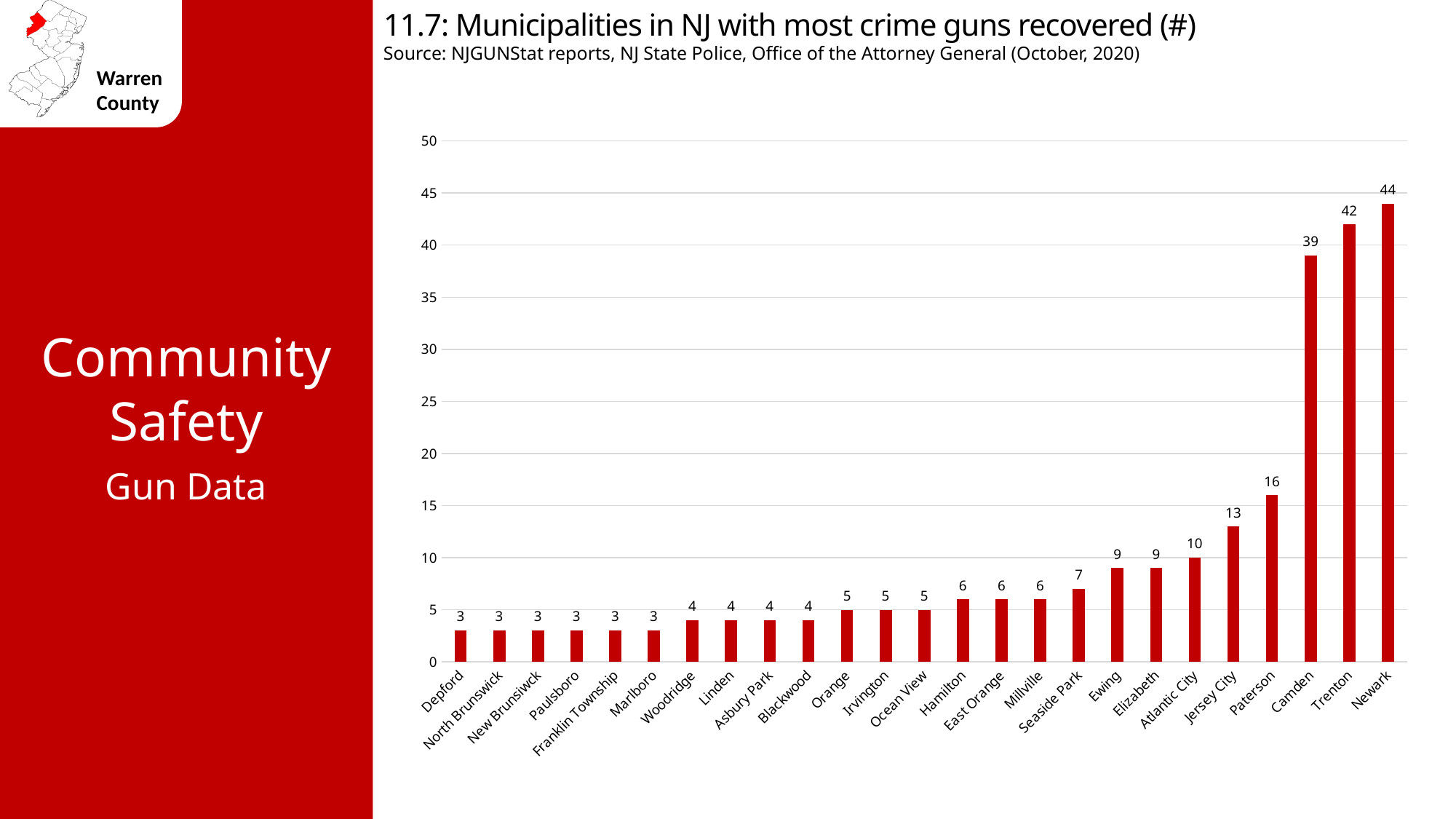
Which has a larger value, Jersey City or Elizabeth? Jersey City Is the value for Trenton greater or less than 40? greater What is the value shown for Camden? 39 What is the value for Atlantic City? 10 How many crime guns were recovered in Newark? 44 What kind of chart is shown on the slide? Bar chart Which municipality has the highest number of crime guns recovered? Newark What is the difference between the values for Newark and Trenton? 2 How many municipalities are shown on the chart? 25 Do the values rise or fall moving from left to right along the x axis? Rise How many crime guns were recovered in Paterson? 16 What is the difference between the values for Camden and Paterson? 23